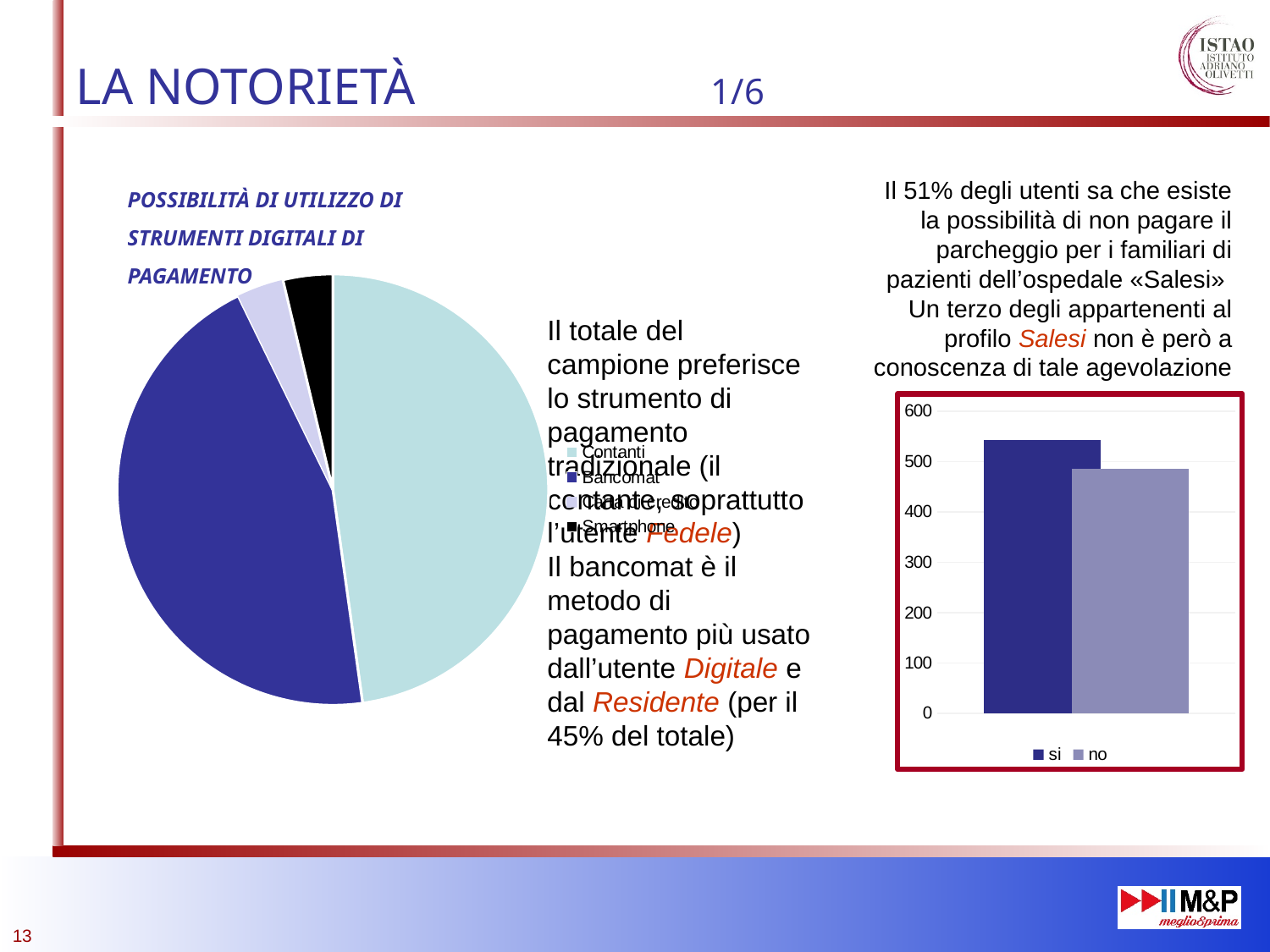
In the pie chart on the left, which slice is larger, Bancomat or Smartphone? Bancomat In the bar chart on the right, how many series does the legend list? 2 In the bar chart on the right, what colour is the bar for 'si'? dark blue In the bar chart on the right, which series has the taller bar, 'si' or 'no'? si In the pie chart on the left, how many slices are there? 4 In the bar chart on the right, is the value for 'no' greater or less than 500? less In the pie chart on the left, which category has the largest slice? Contanti In the bar chart on the right, is the value for 'si' greater or less than 500? greater What kind of chart is the chart on the left of the slide, under the heading 'POSSIBILITÀ DI UTILIZZO DI STRUMENTI DIGITALI DI PAGAMENTO'? pie chart What kind of chart is the chart on the right of the slide, inside the red border? bar chart In the pie chart on the left, which slice is larger, Contanti or Bancomat? Contanti In the bar chart on the right, what is the highest value shown on the vertical axis? 600